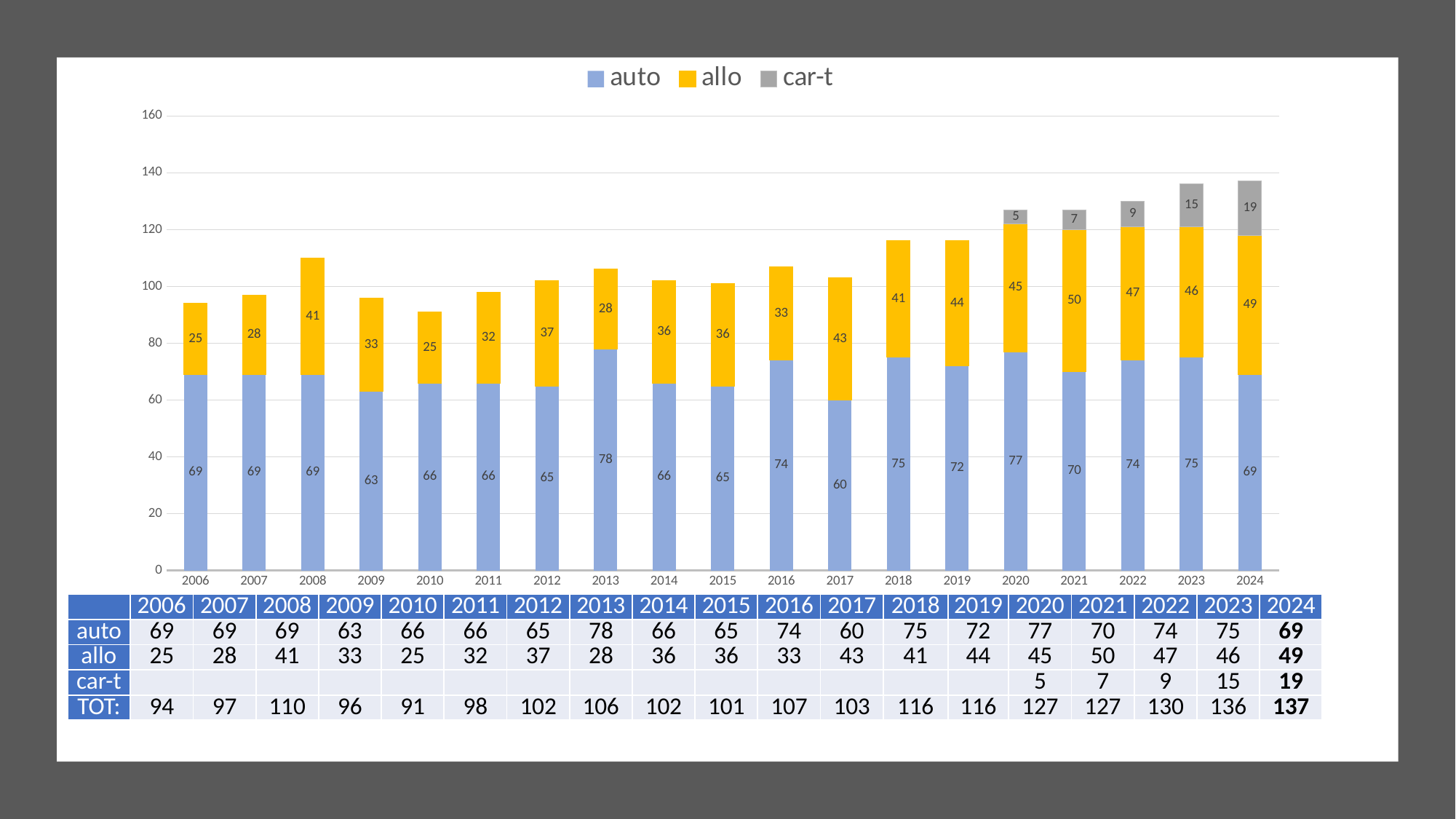
What is the difference between the allo values for 2021 and 2006? 25 How many years are shown on the x axis? 19 Which is larger, the auto value in 2017 or the auto value in 2020? 2020 Is the total stacked bar for 2010 greater or less than 100? less What is the value of the car-t series in 2023? 15 Which year has the lowest allo value? 2006 and 2010 What kind of chart is shown on the slide? stacked bar chart Which year has the highest auto value? 2013 What is the total of the stacked bar for 2024? 137 What is the value of the allo series in 2021? 50 How many series does the legend list? 3 What is the value of the auto series in 2013? 78